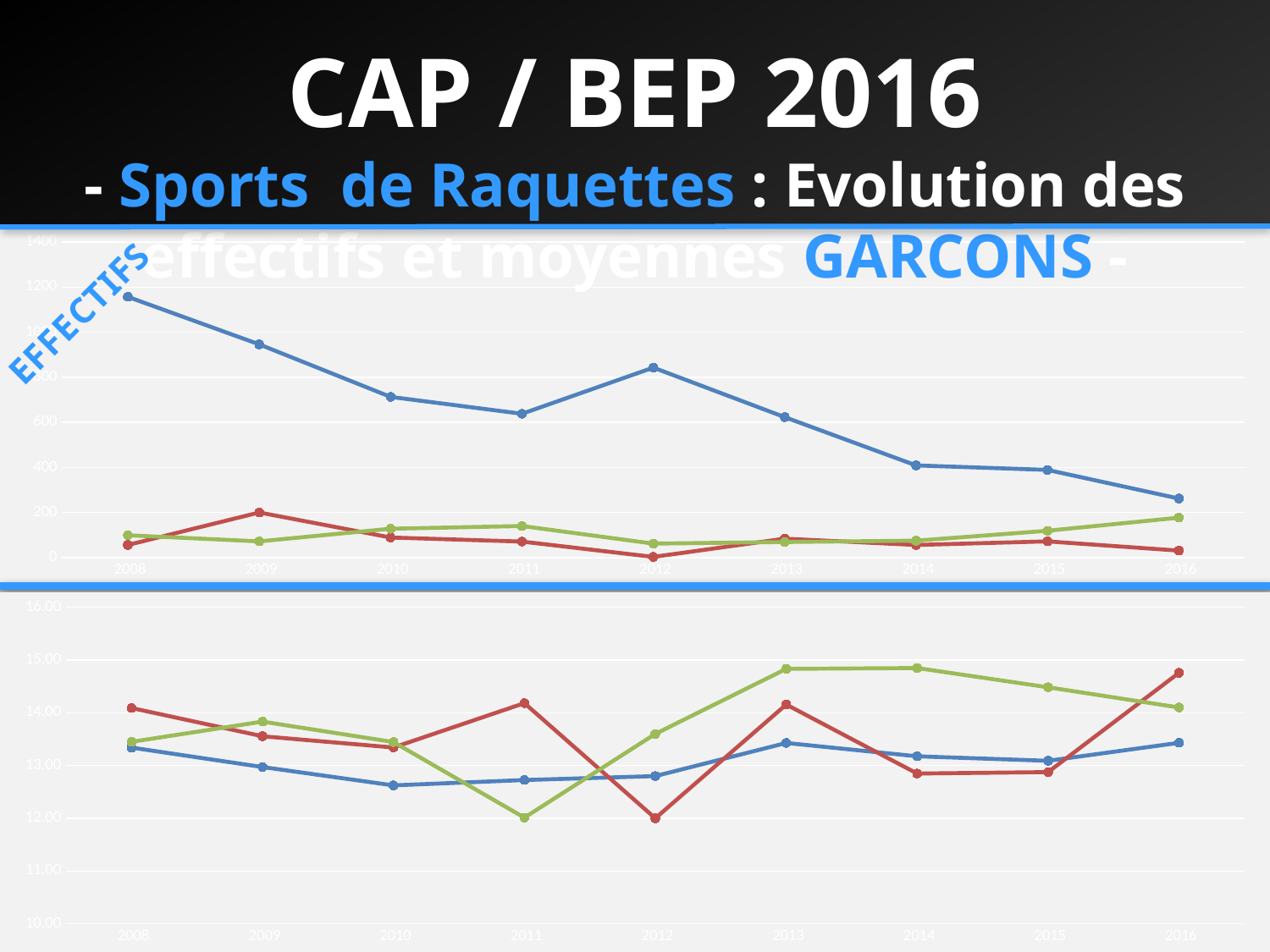
What type of chart is the top chart (EFFECTIFS)? line chart In the bottom chart, in which year does the green line reach its lowest value? 2011 In the top chart (EFFECTIFS), is the value of the blue line in 2010 greater or less than 800? less In the top chart (EFFECTIFS), in which year does the green line reach its highest value? 2016 In the bottom chart, is the value of the red line in 2016 greater or less than 14.00? greater In the top chart (EFFECTIFS), does the blue line rise or fall overall from 2008 to 2016? fall In the top chart (EFFECTIFS), which line has the larger value in 2008, the blue line or the red line? blue line In the top chart (EFFECTIFS), in which year does the red line reach its highest value? 2009 In the top chart (EFFECTIFS), how many years are shown on the x axis? 9 In the top chart (EFFECTIFS), how many lines (data series) are plotted? 3 In the top chart (EFFECTIFS), is the value of the blue line in 2008 greater or less than 1000? greater In the bottom chart, which line has the larger value in 2012, the green line or the red line? green line